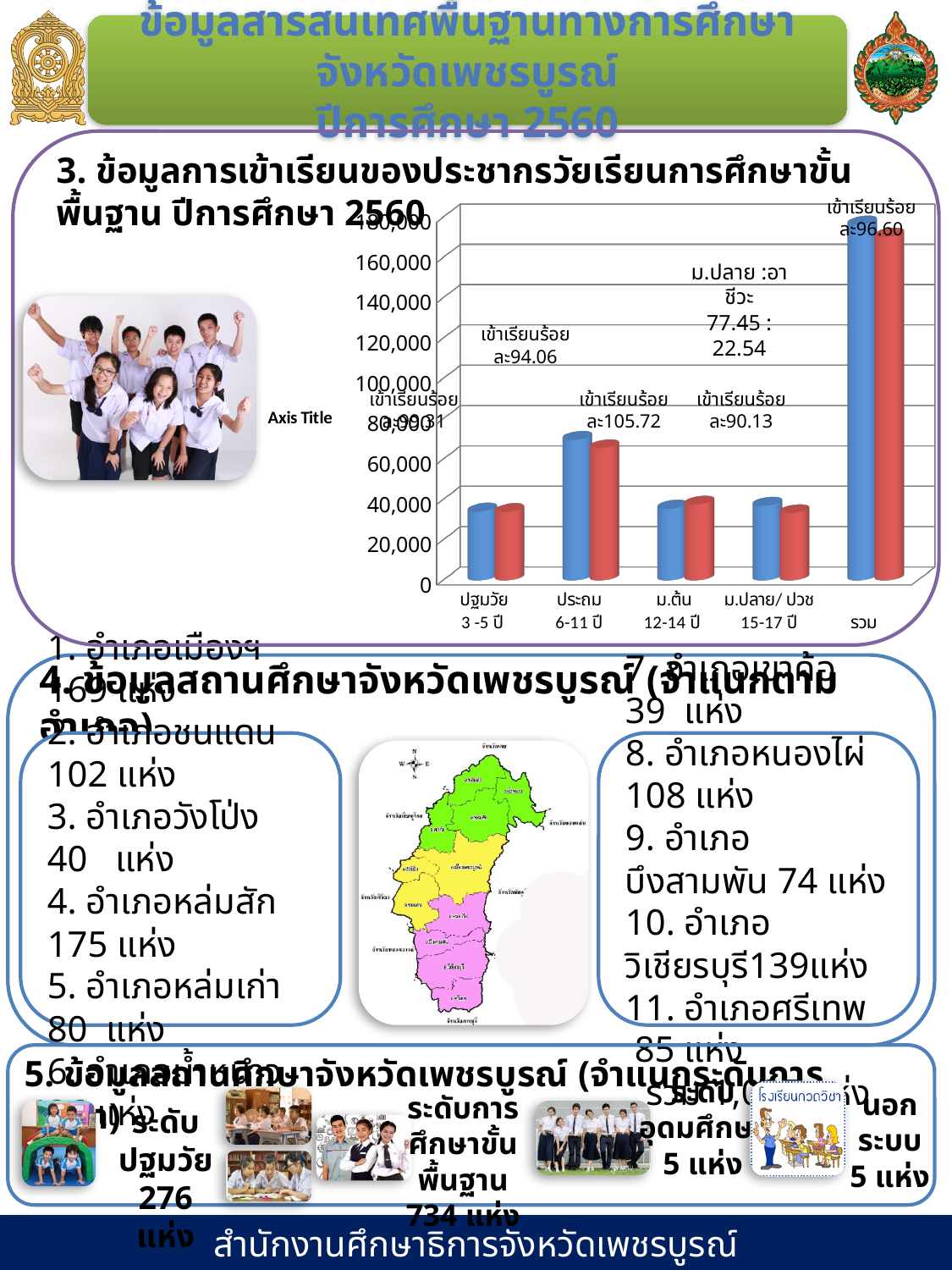
Is the value of the blue bar for ปฐมวัย 3-5 ปี greater or less than 40,000? less What percentage is written in the annotation above the รวม bars? 96.60 Is the value of the blue bar for รวม greater or less than 160,000? greater Is the value of the red bar for รวม greater or less than 140,000? greater Which has the larger red bar, รวม or ประถม 6-11 ปี? รวม What percentage is written in the annotation above the ประถม 6-11 ปี bars? 105.72 Which category has the tallest bars in the chart? รวม Which has the larger blue bar, ประถม 6-11 ปี or ม.ต้น 12-14 ปี? ประถม 6-11 ปี What kind of chart is shown on the slide? bar chart How many categories are shown along the x axis of the chart? 5